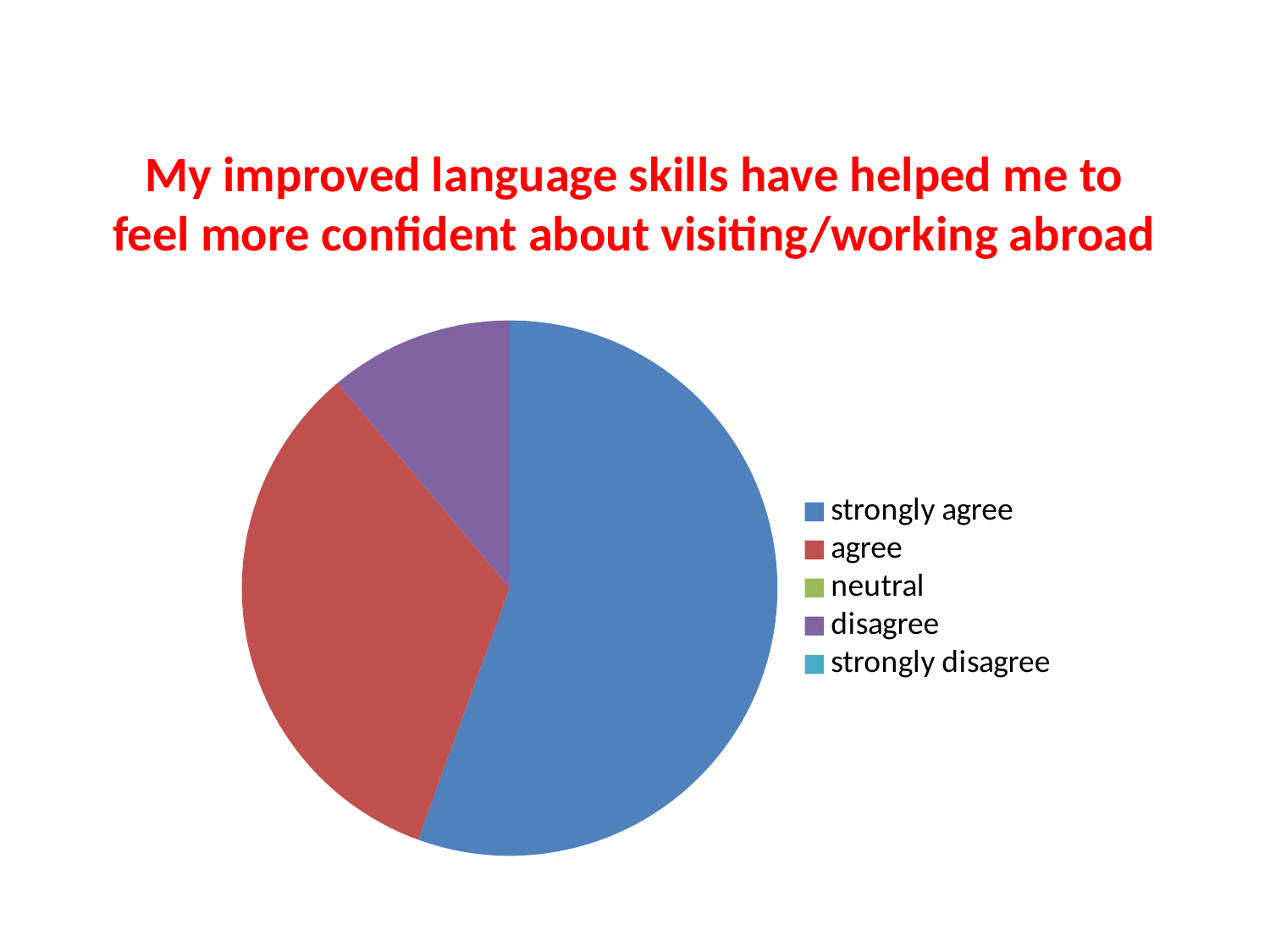
Which category has the largest slice of the pie? strongly agree What kind of chart is shown on the slide? pie chart Which slice is larger, agree or disagree? agree What colour represents the agree category in the legend? red How many slices are visible in the pie? 3 What is the title of the chart? My improved language skills have helped me to feel more confident about visiting/working abroad Which slice is larger, strongly agree or agree? strongly agree Is the strongly agree slice greater or less than half of the pie? greater How many entries does the legend list? 5 Of the slices visible in the pie, which is the smallest? disagree